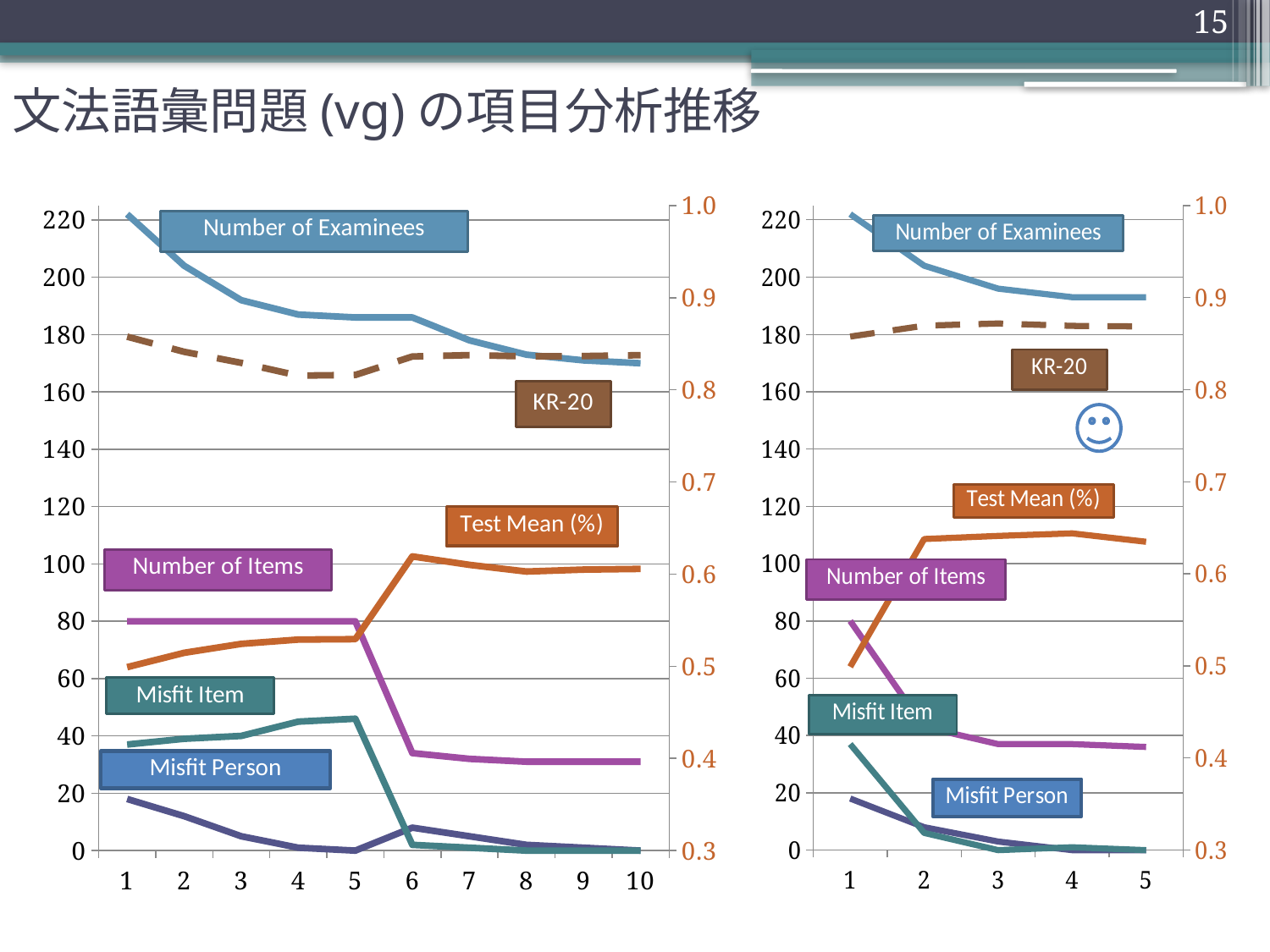
How many points are on the x axis of the left chart? 10 On the left chart, which series is drawn as a dashed line? KR-20 On the right chart, does Number of Items rise or fall from point 1 to point 5? fall On the left chart, is the value for Number of Items at point 10 greater or less than 40? less How many labelled series are plotted on the left chart? 6 What kind of chart is the left chart on the slide? line chart On the left chart, does Test Mean (%) rise or fall from point 1 to point 6? rise On the left chart, does Number of Examinees rise or fall from point 1 to point 10? fall How many points are on the x axis of the right chart? 5 On the left chart, is the value for Number of Examinees at point 1 greater or less than 200? greater On the right chart, is the value for KR-20 at point 5 greater or less than 0.8? greater